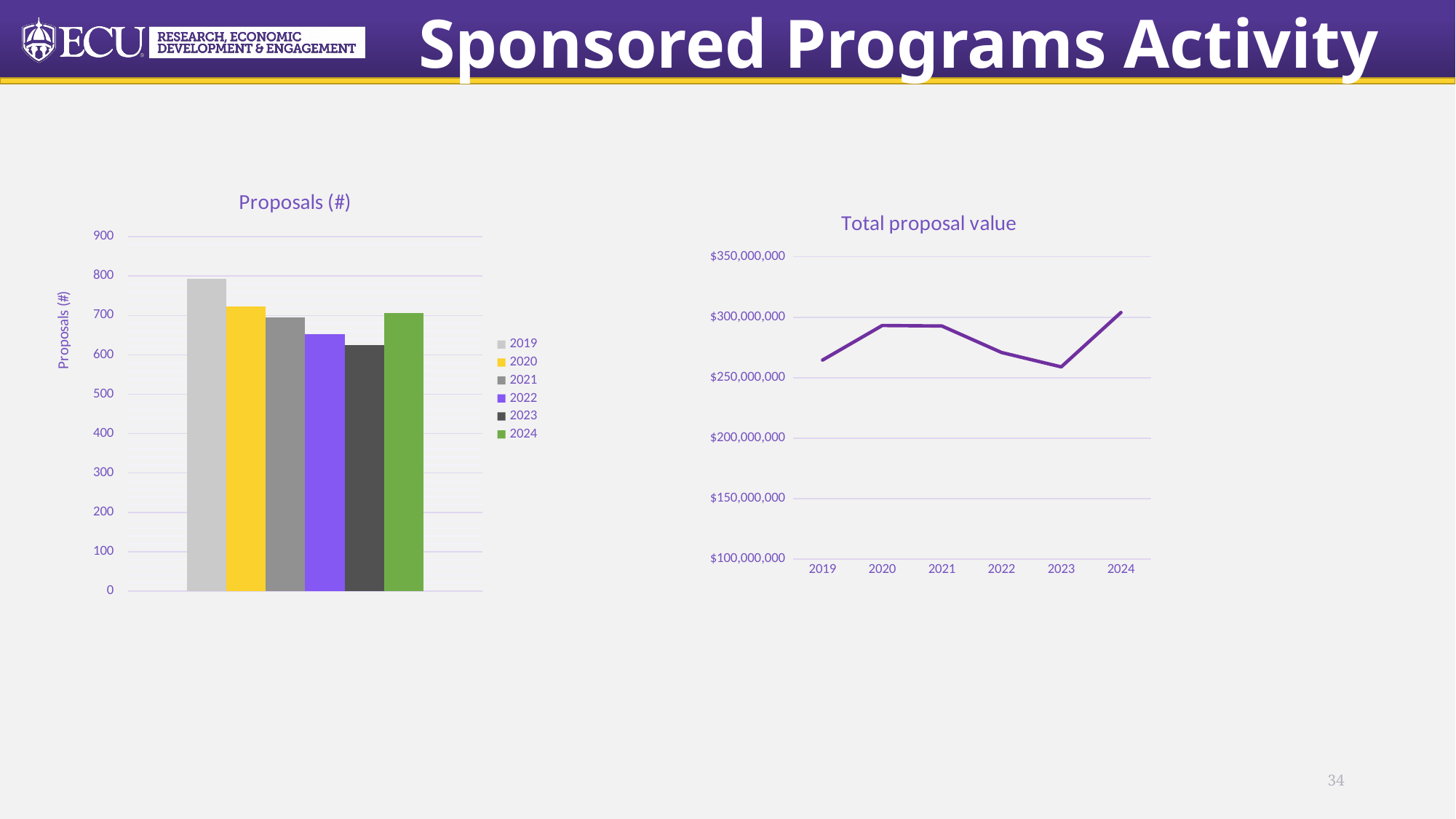
In the 'Proposals (#)' chart, how many series does the legend list? 6 In the 'Proposals (#)' chart, is the value for 2019 greater or less than 700? greater In the 'Proposals (#)' chart, which year has the highest number of proposals? 2019 In the 'Proposals (#)' chart, is the value for 2023 greater or less than 700? less In the 'Total proposal value' chart, is the value for 2024 greater or less than $300,000,000? greater In the 'Proposals (#)' chart, which is larger, the value for 2019 or the value for 2024? 2019 What kind of chart is the 'Total proposal value' chart? line chart In the 'Total proposal value' chart, how many years are plotted on the x axis? 6 In the 'Total proposal value' chart, which year has the lowest total proposal value? 2023 In the 'Proposals (#)' chart, which year has the lowest number of proposals? 2023 In the 'Total proposal value' chart, which year has the highest total proposal value? 2024 What kind of chart is the 'Proposals (#)' chart? bar chart